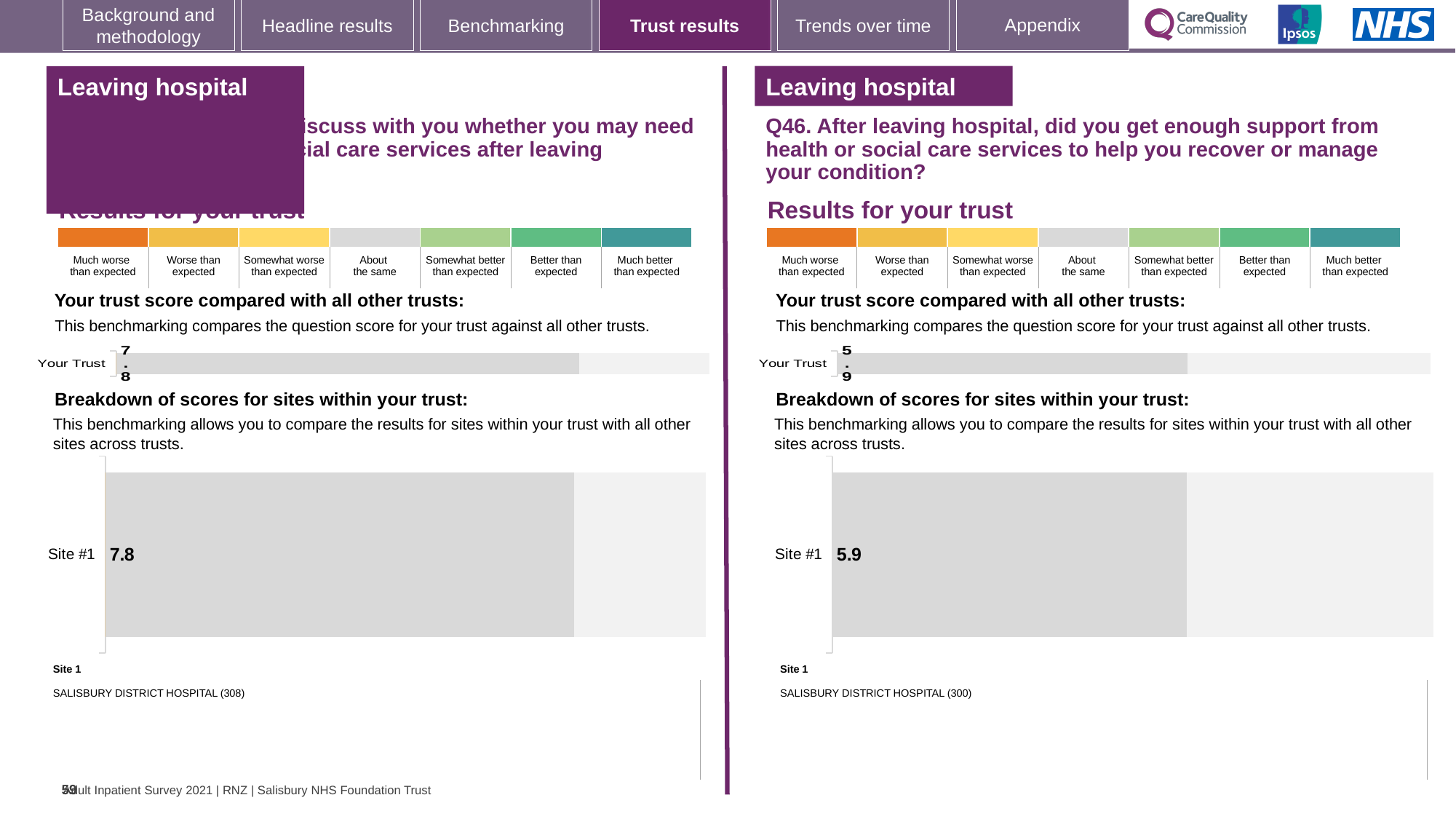
On the right half of the slide (Q46), what is the score shown for Your Trust? 5.9 What is the difference between the Site #1 score on the left half of the slide and the Site #1 score on the right half (Q46)? 1.9 Which is larger: the Your Trust score on the left half of the slide or the Your Trust score on the right half (Q46)? Left half (7.8) In the left-hand site breakdown chart, what is the score for Site #1? 7.8 How many sites are shown in the site breakdown chart on the right half of the slide (Q46)? 1 Is the Your Trust score on the right half of the slide (Q46) the same as the Site #1 score on that half? Yes, both 5.9 Which site is listed as Site 1 in the right-hand breakdown for Q46? SALISBURY DISTRICT HOSPITAL (300) How many categories does the colour scale above the left-hand 'Results for your trust' chart show? 7 What type of chart is used to show the Site #1 score on the left half of the slide? Bar chart In the right-hand site breakdown chart for Q46, what is the score for Site #1? 5.9 On the left half of the slide, what is the score shown for Your Trust? 7.8